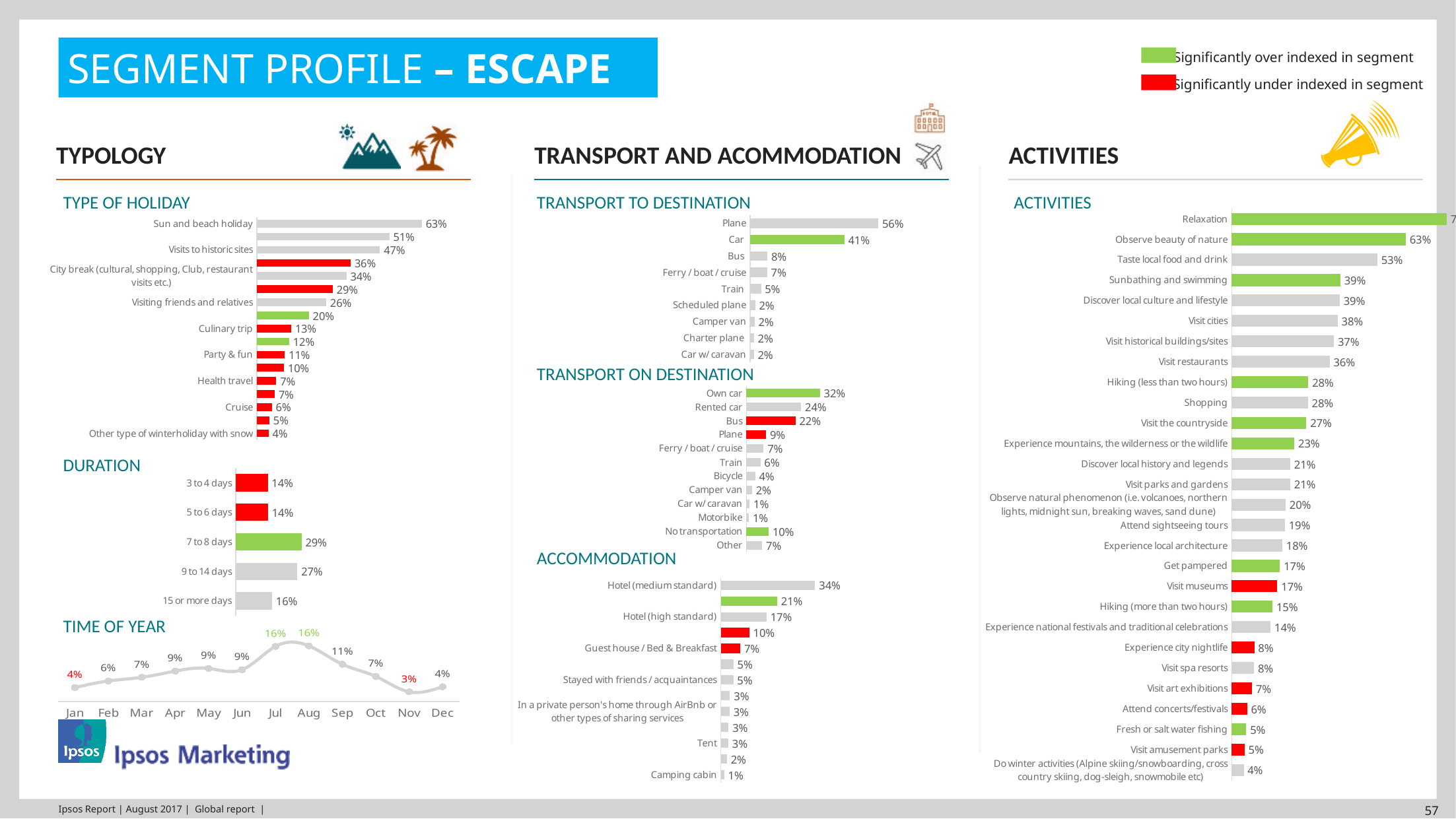
In the Duration chart, which category has the highest value? 7 to 8 days In the Time of Year chart, what is the value for Nov? 3% In the Activities chart, what is the value for Observe beauty of nature? 63% In the Duration chart, what is the difference between 7 to 8 days and 15 or more days? 13% In the Accommodation chart, what is the value for Hotel (medium standard)? 34% What kind of chart is the Time of Year chart? Line chart In the Activities chart, what is the difference between Taste local food and drink and Visit cities? 15% In the Transport on Destination chart, which is larger, Rented car or Bus? Rented car In the Time of Year chart, which months have the highest value? Jul and Aug In the Transport on Destination chart, what is the value for Own car? 32% In the Transport to Destination chart, what is the value for Plane? 56% In the Transport to Destination chart, what is the value for Car? 41%